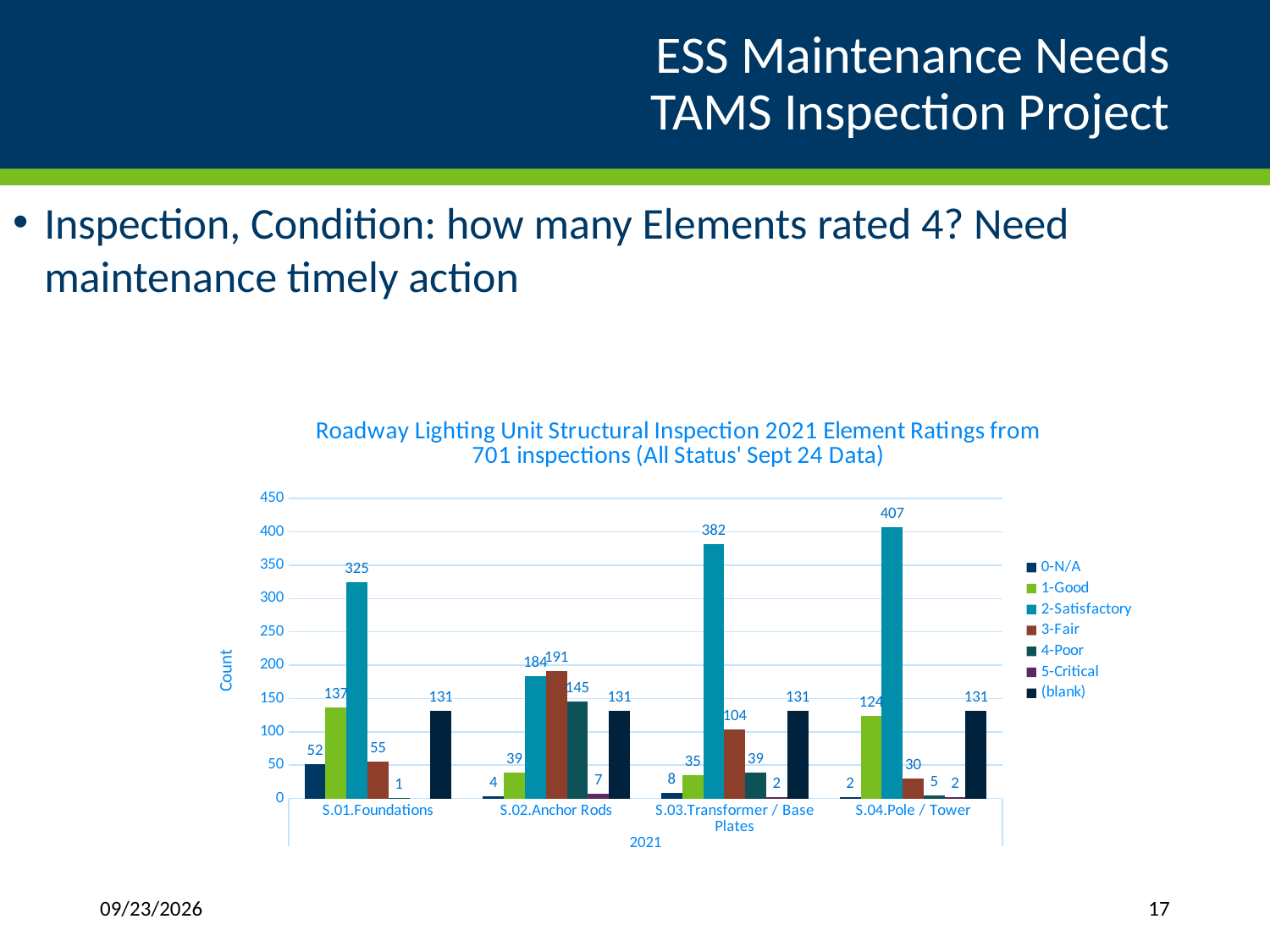
What is the 3-Fair count for S.03.Transformer / Base Plates? 104 What is the 1-Good count for S.01.Foundations? 137 How many series does the legend list? 7 How many element categories are shown on the x axis? 4 Which is larger for S.02.Anchor Rods: the 2-Satisfactory count or the 3-Fair count? 3-Fair What is the 4-Poor count for S.02.Anchor Rods? 145 Which category has the lowest 4-Poor count? S.01.Foundations Which category has the highest 2-Satisfactory count? S.04.Pole / Tower What is the label on the vertical axis of the chart? Count What is the difference between the 2-Satisfactory counts for S.04.Pole / Tower and S.03.Transformer / Base Plates? 25 What is the 2-Satisfactory count for S.04.Pole / Tower? 407 What type of chart is shown on the slide? bar chart